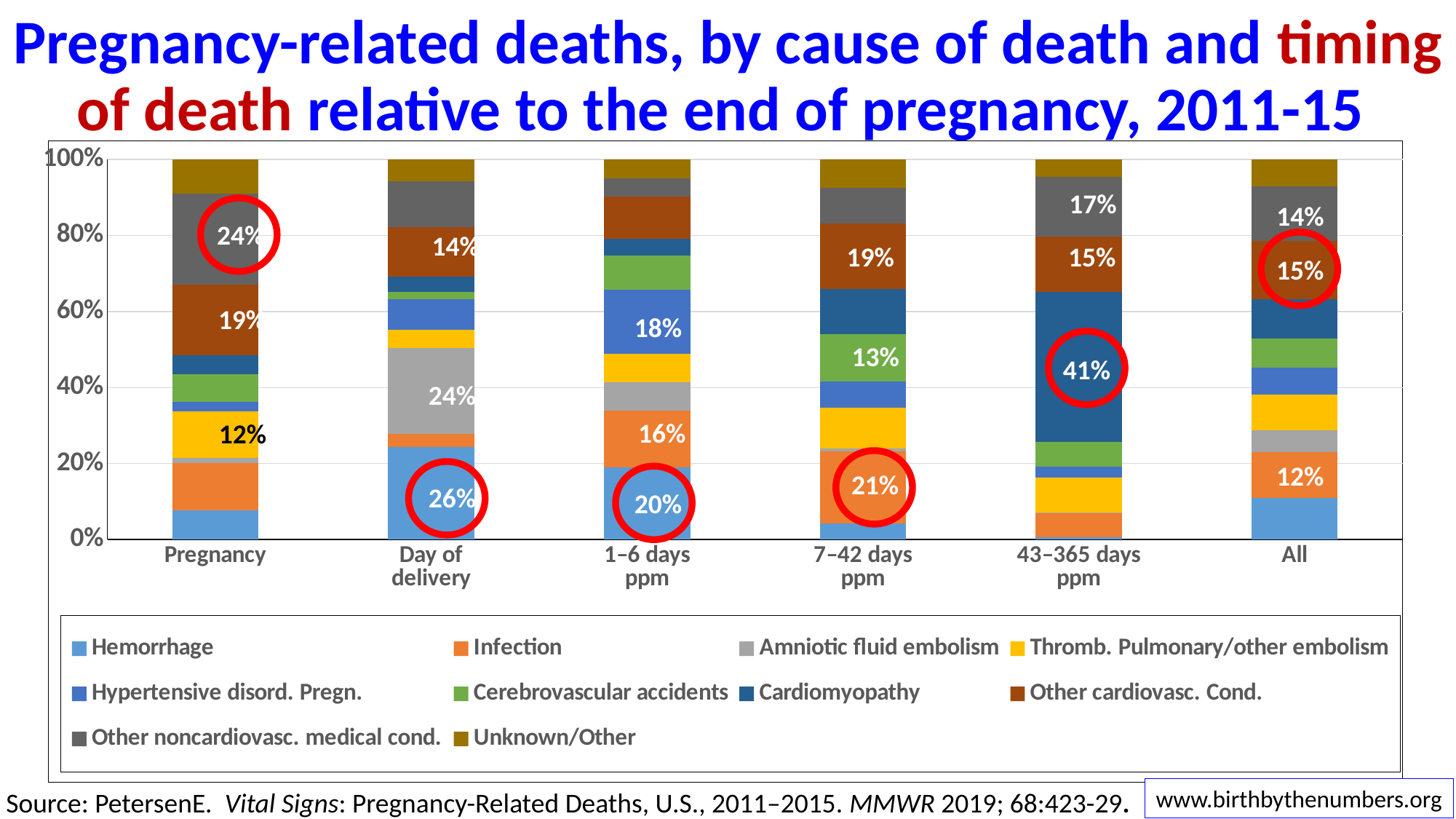
How many timing categories are shown along the x axis? 6 What percentage of deaths during Pregnancy were due to Other noncardiovasc. medical cond.? 24% What share of deaths in the 43–365 days ppm period were due to Cardiomyopathy? 41% What percentage of pregnancy-related deaths on the Day of delivery were due to Hemorrhage? 26% What kind of chart is shown on the slide? Stacked bar chart Is the Hemorrhage share in the All category greater or less than 20%? less What share of deaths in the 1–6 days ppm period were due to Hypertensive disord. Pregn.? 18% How many causes of death does the legend list? 10 What is the difference between the Other cardiovasc. Cond. share during Pregnancy and in the All category? 4 percentage points What percentage of Day of delivery deaths were due to Amniotic fluid embolism? 24% What share of deaths in the 7–42 days ppm period were due to Infection? 21% Which has a larger Hemorrhage share: Day of delivery or 1–6 days ppm? Day of delivery